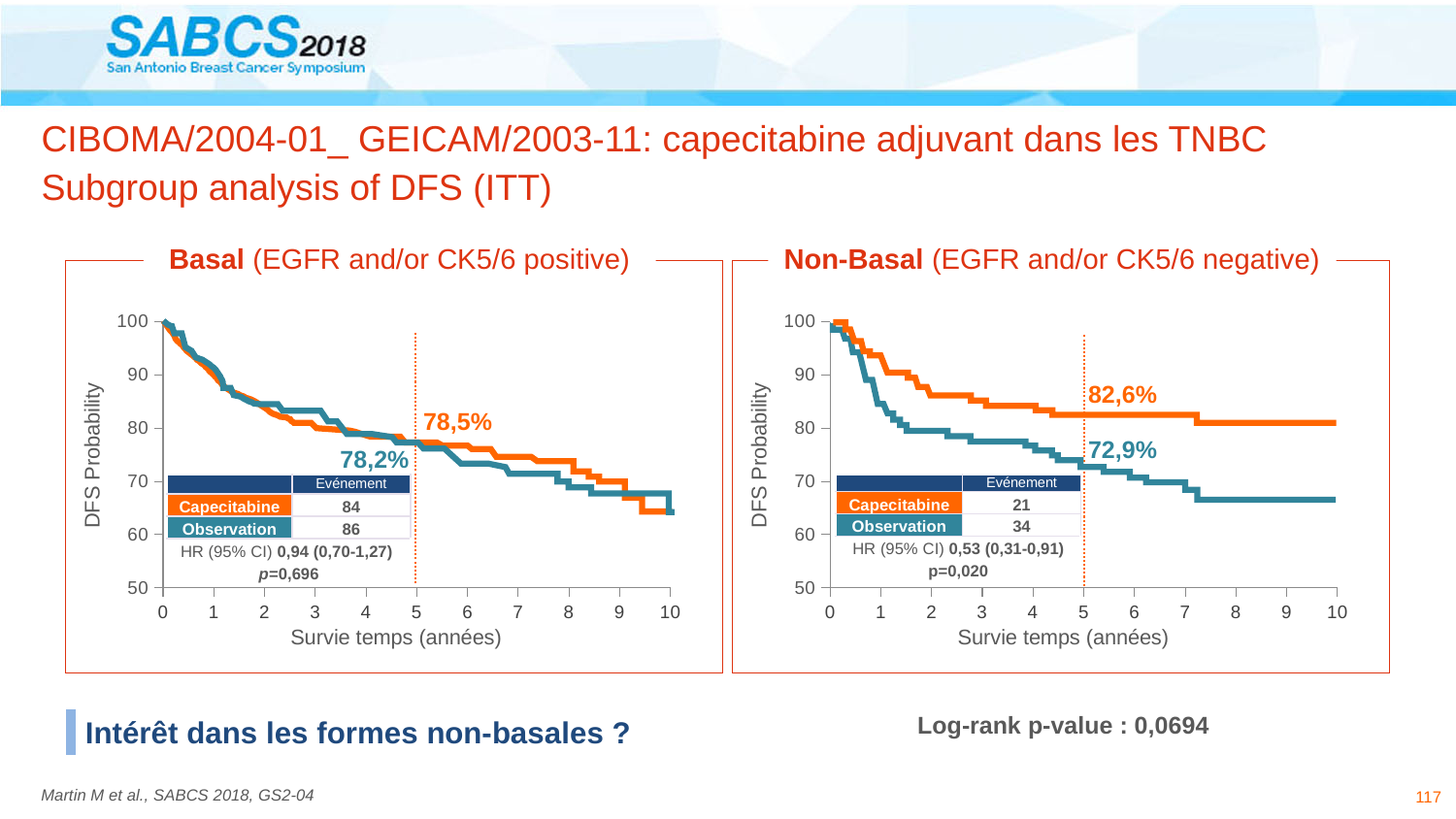
In the Non-Basal chart, which arm has the higher DFS probability at 5 years? Capecitabine In the Basal chart, how many events are reported for the Capecitabine arm? 84 How many treatment arms (series) are plotted in the Non-Basal chart? 2 In the Non-Basal chart, is the DFS probability of the Observation arm at 8 years greater or less than 70? less What kind of chart is used in the Basal and Non-Basal panels? Line chart (Kaplan-Meier survival curve) In the Basal chart, what is the 5-year DFS probability shown for the Capecitabine arm? 78,5% In the Non-Basal chart, what is the hazard ratio with its 95% CI? 0,53 (0,31-0,91) In the Non-Basal chart, what is the 5-year DFS probability shown for the Observation arm? 72,9% In the Non-Basal chart, what is the difference between the 5-year DFS probabilities of the Capecitabine and Observation arms? 9,7 percentage points In the Basal chart, does the DFS probability rise or fall as survival time increases? Fall In the Basal chart, what p-value is reported? p=0,696 In the Non-Basal chart, how many events are reported for the Observation arm? 34